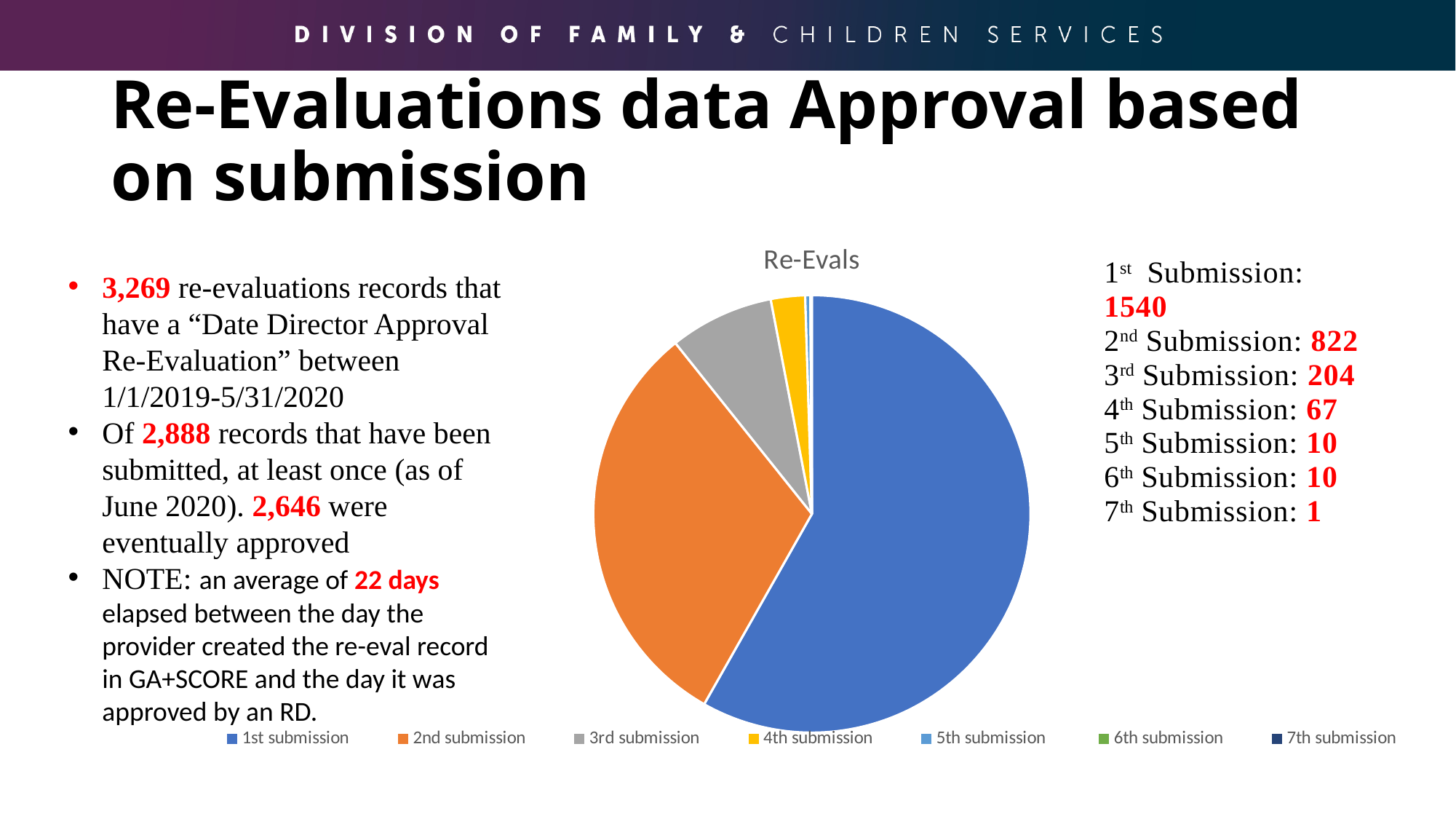
Which submission category has the largest slice in the Re-Evals pie chart? 1st submission How many entries does the legend of the pie chart list? 7 What is the difference between the 1st submission count and the 2nd submission count? 718 How many slices does the Re-Evals pie chart have? 7 Which submission category has the smallest slice in the Re-Evals pie chart? 7th submission What kind of chart is shown on the slide? pie chart What is the title of the pie chart? Re-Evals How many re-evaluations were approved on the 3rd submission? 204 How many re-evaluations were approved on the 4th submission? 67 How many re-evaluations were approved on the 1st submission? 1540 What colour is the 2nd submission slice in the Re-Evals pie chart? orange Which is larger in the Re-Evals pie chart, the 2nd submission slice or the 3rd submission slice? 2nd submission